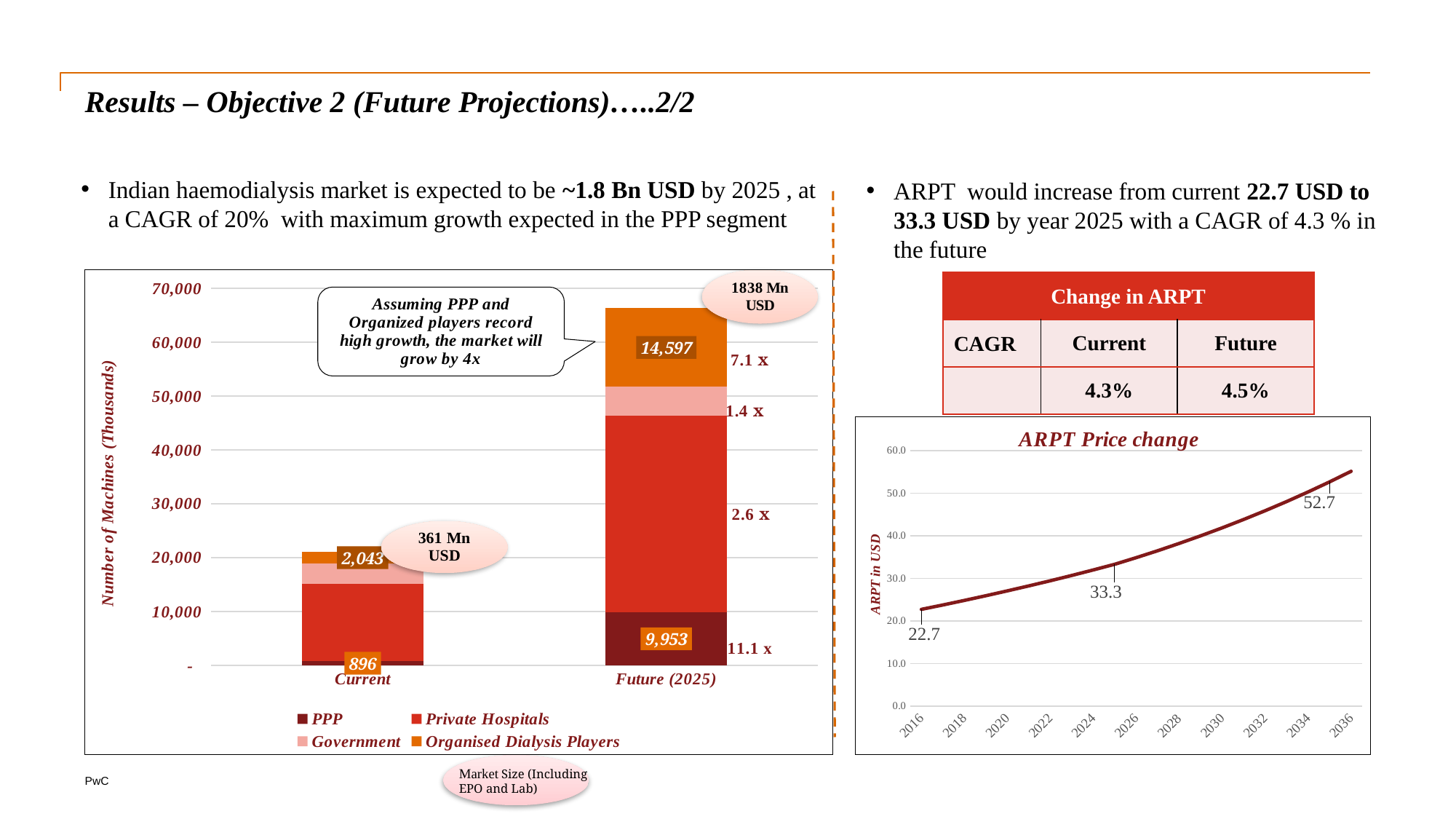
In the left chart (Number of Machines), is the total of the Current stacked bar greater or less than 30,000? less In the 'ARPT Price change' chart, what is the labelled value at 2016? 22.7 What kind of chart is the chart on the left of the slide (Number of Machines)? Stacked bar chart In the left chart (Number of Machines), how many categories are shown on the x axis? 2 In the left chart (Number of Machines), what is the value for PPP in the Future (2025) bar? 9,953 In the left chart (Number of Machines), what is the value for PPP in the Current bar? 896 In the left chart (Number of Machines), what is the difference between the Organised Dialysis Players value in Future (2025) and in Current? 12,554 In the left chart (Number of Machines), what is the value for Organised Dialysis Players in the Current bar? 2,043 In the left chart (Number of Machines), which stacked bar is taller, Current or Future (2025)? Future (2025) In the left chart (Number of Machines), how many series does the legend list? 4 What kind of chart is the 'ARPT Price change' chart on the right? Line chart In the 'ARPT Price change' chart, do the values rise or fall from 2016 to 2036? Rise